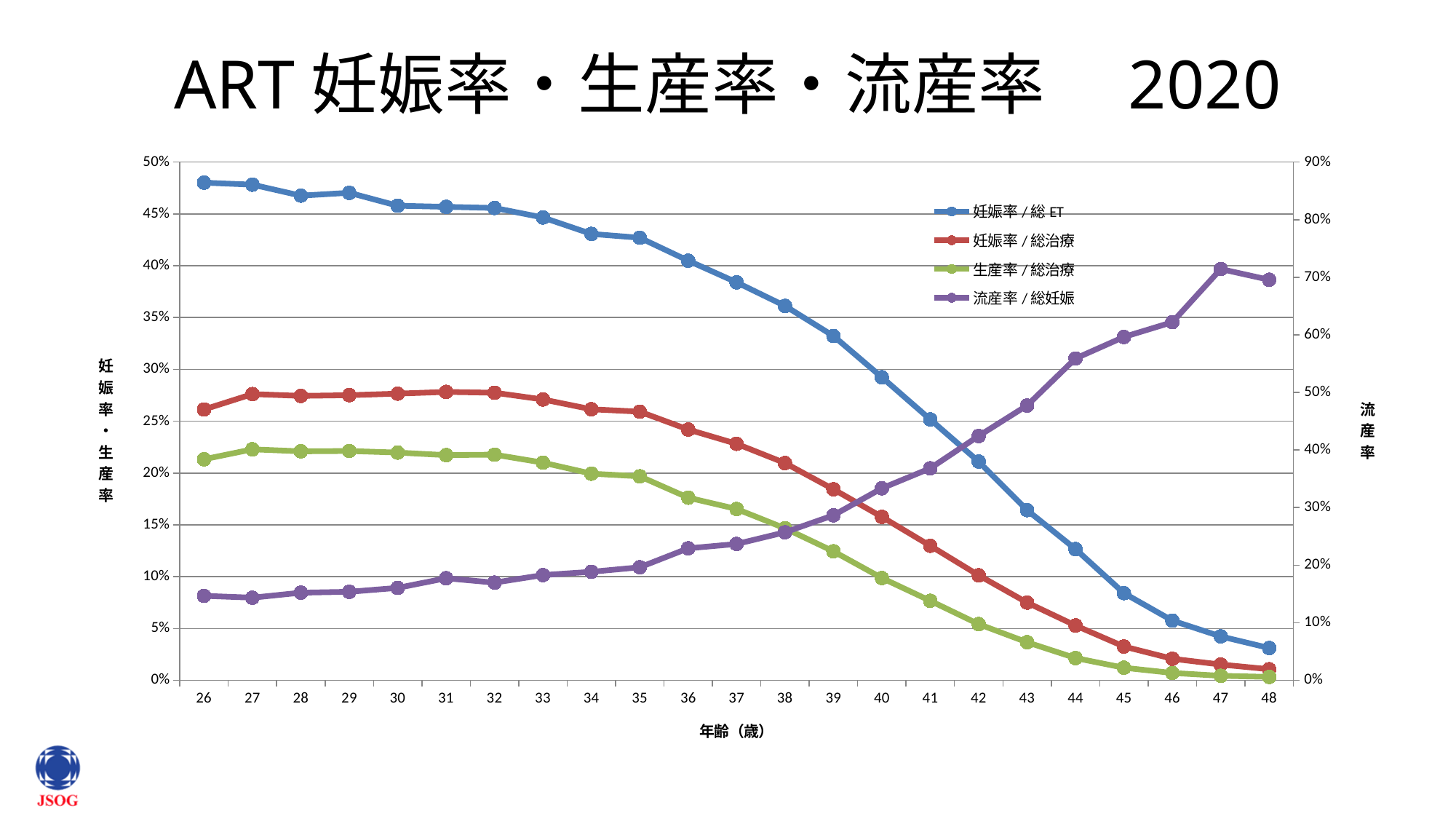
Is the value for 生産率 / 総治療 at age 44 greater or less than 5%? less At which age is the 妊娠率 / 総 ET series lowest? 48 What kind of chart is shown on the slide? line chart How many age categories are plotted along the x axis? 23 Does the 妊娠率 / 総 ET series rise or fall as age increases? fall Is the value for 流産率 / 総妊娠 at age 47 greater or less than 60% on the right axis? greater How many series does the legend list? 4 Does the 流産率 / 総妊娠 series rise or fall as age increases? rise At age 35, which is higher, 妊娠率 / 総治療 or 生産率 / 総治療? 妊娠率 / 総治療 Is the value for 妊娠率 / 総治療 at age 30 greater or less than 25%? greater What is the title of the x axis? 年齢（歳）